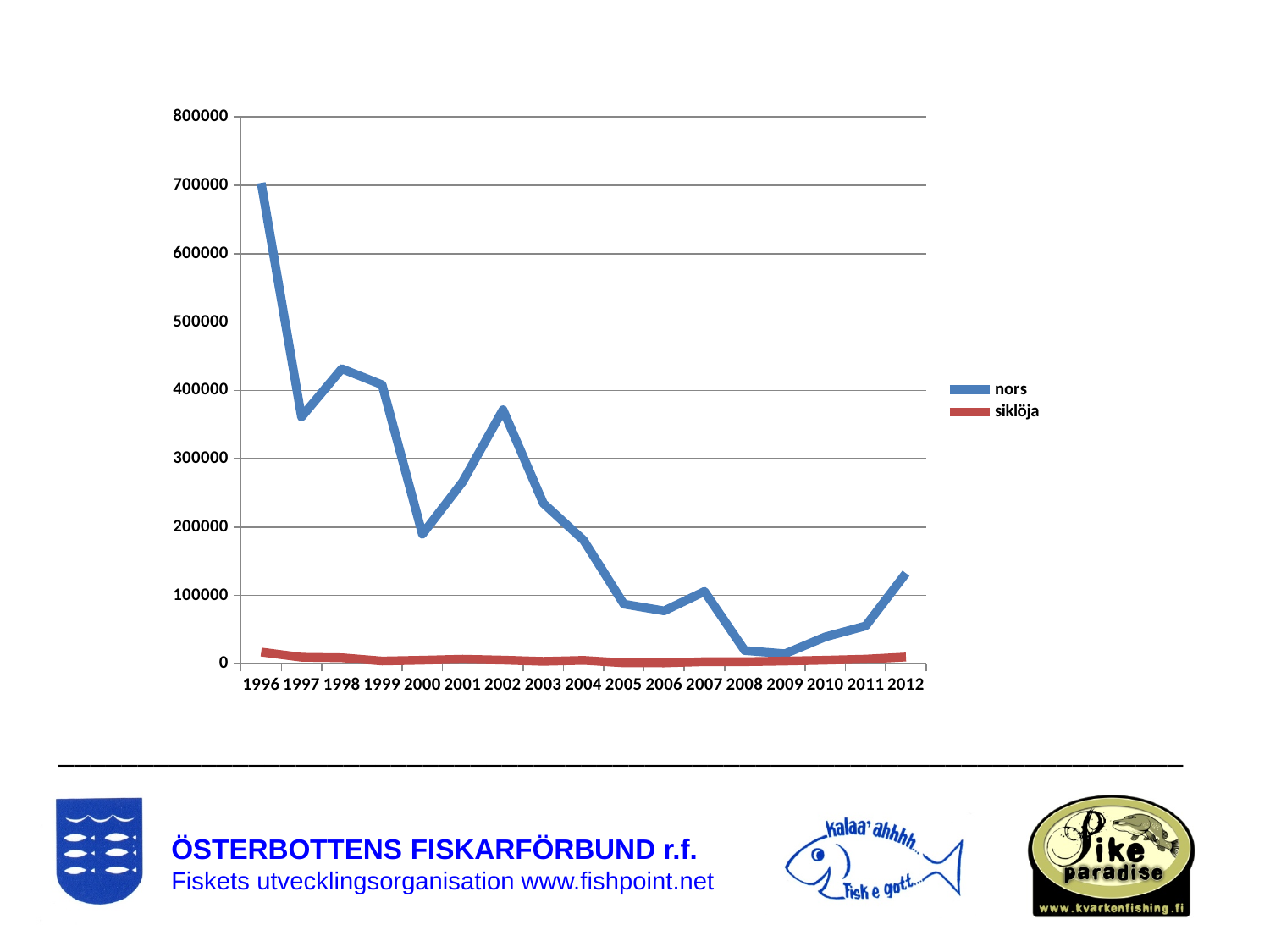
Is the value for nors in 2012 greater or less than 100000? greater In which year is the value for nors highest? 1996 How many series does the legend list? 2 Is the value for nors in 2002 greater or less than 300000? greater How many years are shown along the x axis? 17 Is the value for nors in 2005 greater or less than 100000? less Does the value for nors generally rise or fall from 1996 to 2012? fall Which series has the larger value in 1996, nors or siklöja? nors Which series is drawn in blue? nors What kind of chart is shown on the slide? line chart What are the two entries in the legend? nors and siklöja